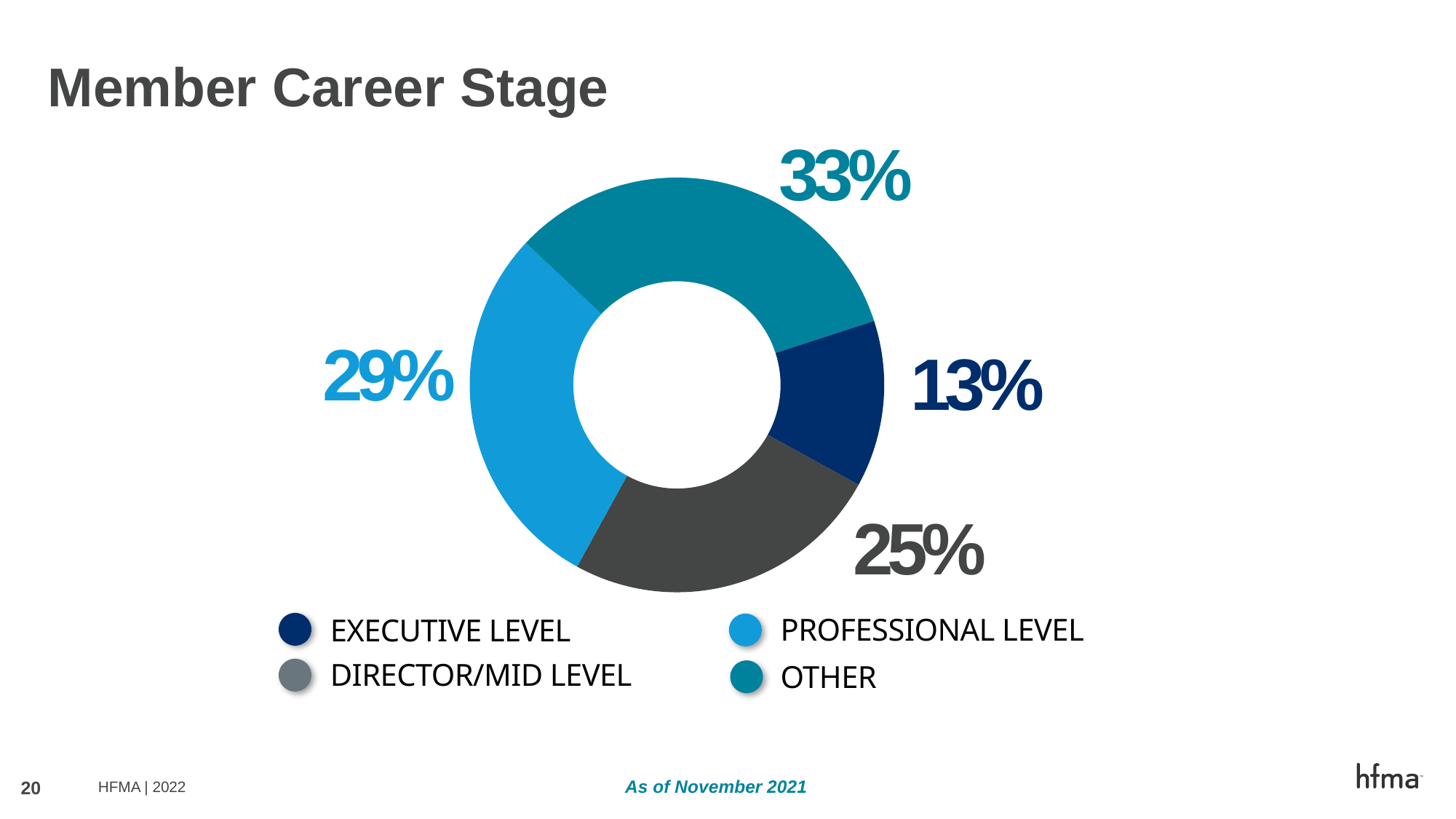
Which career stage category has the largest share? Other Which is larger, the Professional Level share or the Director/Mid Level share? Professional Level What share of members are at the Director/Mid Level? 25% What share of members fall into the Other category? 33% What share of members are at the Executive Level? 13% What is the difference in percentage points between the Other and Executive Level shares? 20 Which career stage category has the smallest share? Executive Level How many categories does the chart show? 4 What kind of chart is shown on the slide? Doughnut (pie) chart What colour represents the Director/Mid Level category? Dark grey What share of members are at the Professional Level? 29% What is the title of the chart? Member Career Stage